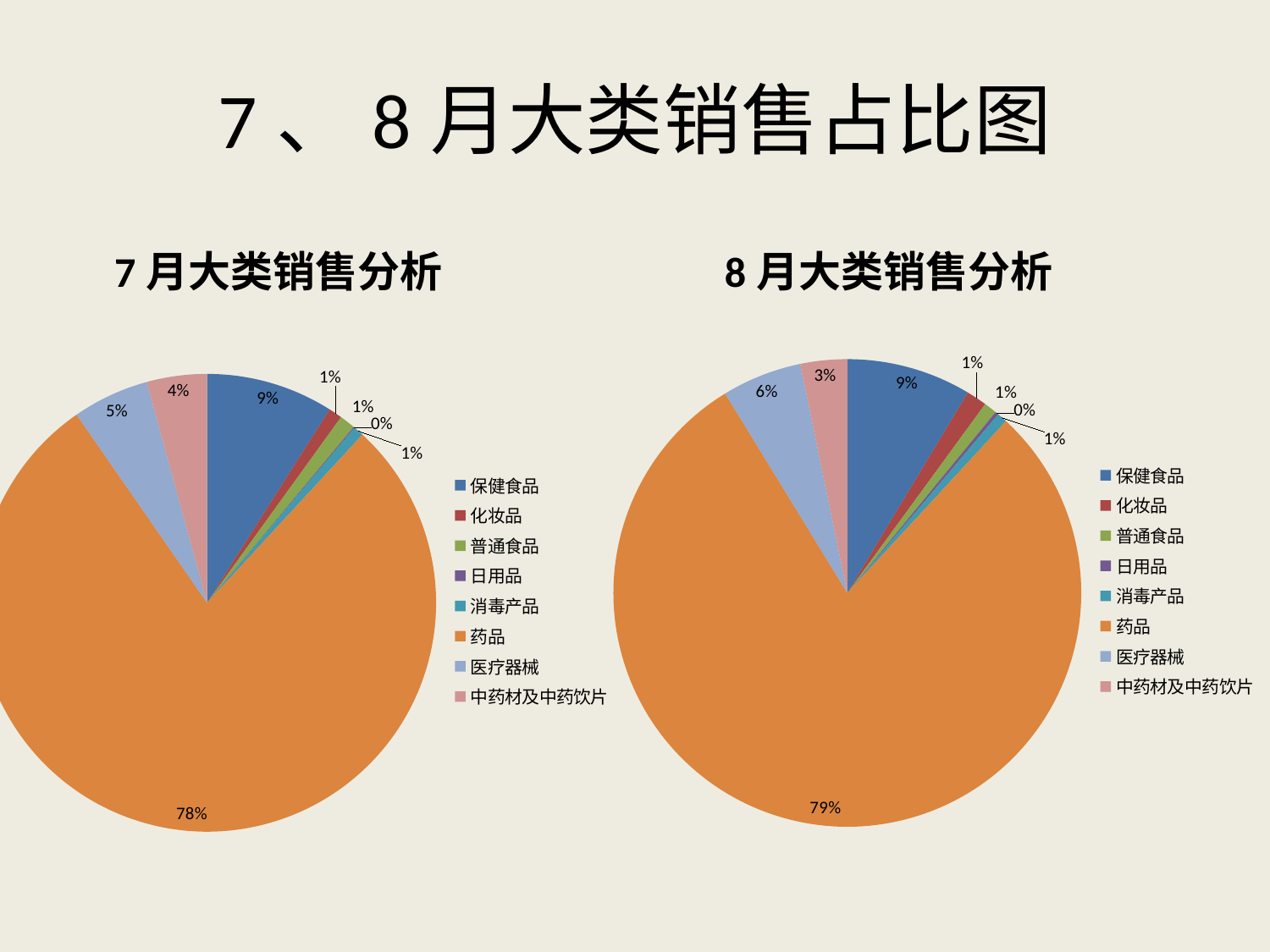
What is the title of the slide? 7、8月大类销售占比图 In the 8月大类销售分析 chart, what is the share for 医疗器械? 6% How many categories does the legend of the 8月大类销售分析 chart list? 8 In the 7月大类销售分析 chart, what is the share for 中药材及中药饮片? 4% In the 7月大类销售分析 chart, what share does 药品 have? 78% In the 8月大类销售分析 chart, which is larger, the share of 医疗器械 or the share of 中药材及中药饮片? 医疗器械 In the 8月大类销售分析 chart, which category has the largest share? 药品 In the 7月大类销售分析 chart, what is the share for 保健食品? 9% In the 7月大类销售分析 chart, which category has the smallest share? 日用品 In the 7月大类销售分析 chart, what is the difference between the shares of 医疗器械 and 中药材及中药饮片? 1% What type of chart is the 7月大类销售分析 chart? Pie chart In the 8月大类销售分析 chart, what share does 药品 have? 79%